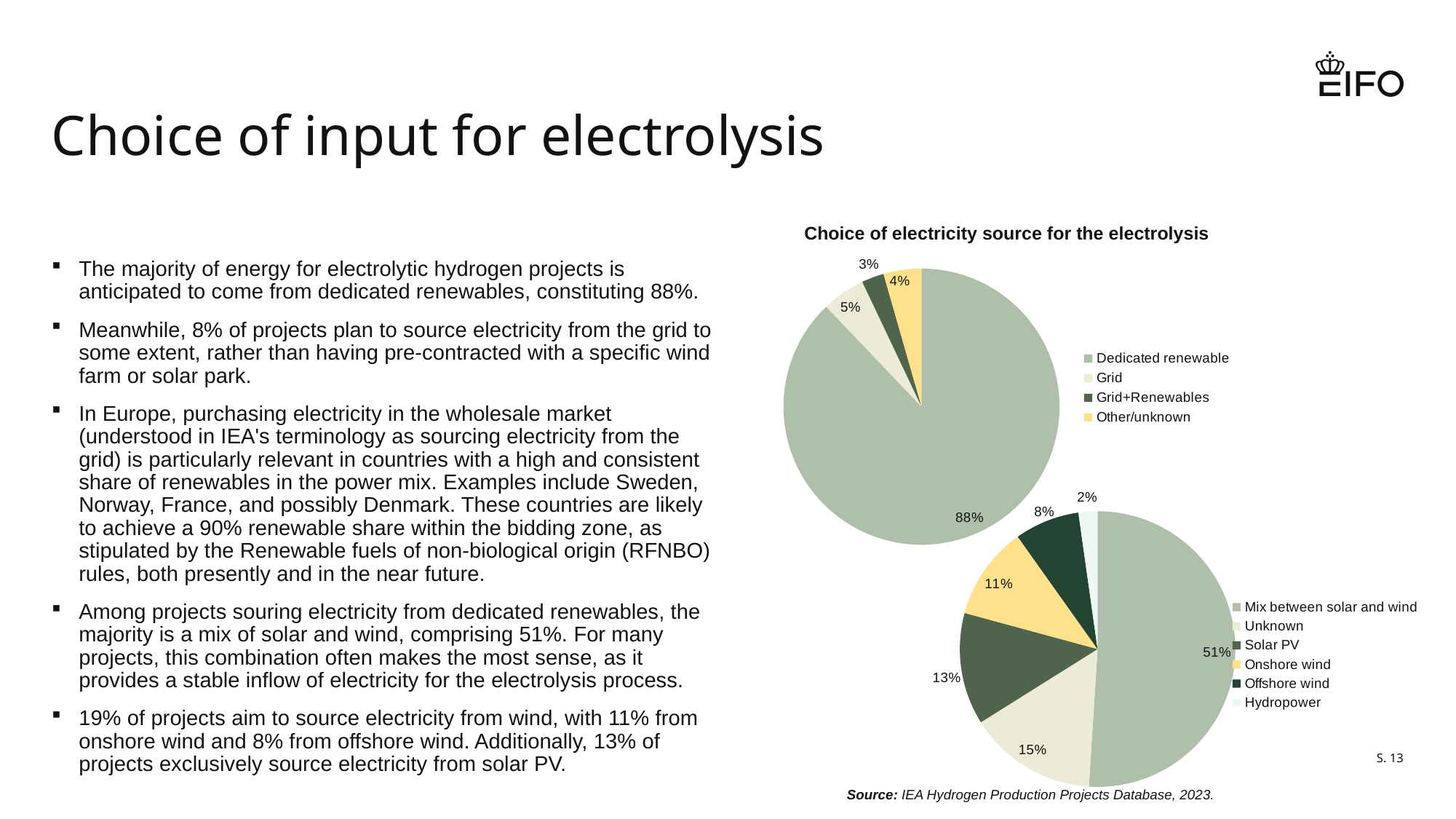
In the chart titled 'Choice of electricity source for the electrolysis', what is the difference between the Grid share and the Grid+Renewables share? 2% In the lower pie chart at the bottom right of the slide, what share is Solar PV? 13% In the lower pie chart at the bottom right of the slide, which category has the smallest share? Hydropower In the chart titled 'Choice of electricity source for the electrolysis', which category has the smallest share? Grid+Renewables In the lower pie chart at the bottom right of the slide, how many categories does the legend list? 6 In the lower pie chart at the bottom right of the slide, what share is Mix between solar and wind? 51% In the chart titled 'Choice of electricity source for the electrolysis', what share is Grid? 5% In the chart titled 'Choice of electricity source for the electrolysis', how many entries does the legend list? 4 In the lower pie chart at the bottom right of the slide, which is larger: Onshore wind or Offshore wind? Onshore wind In the chart titled 'Choice of electricity source for the electrolysis', what share is Dedicated renewable? 88% In the lower pie chart at the bottom right of the slide, what is the combined share of Onshore wind and Offshore wind? 19% What kind of chart is the upper chart titled 'Choice of electricity source for the electrolysis'? Pie chart